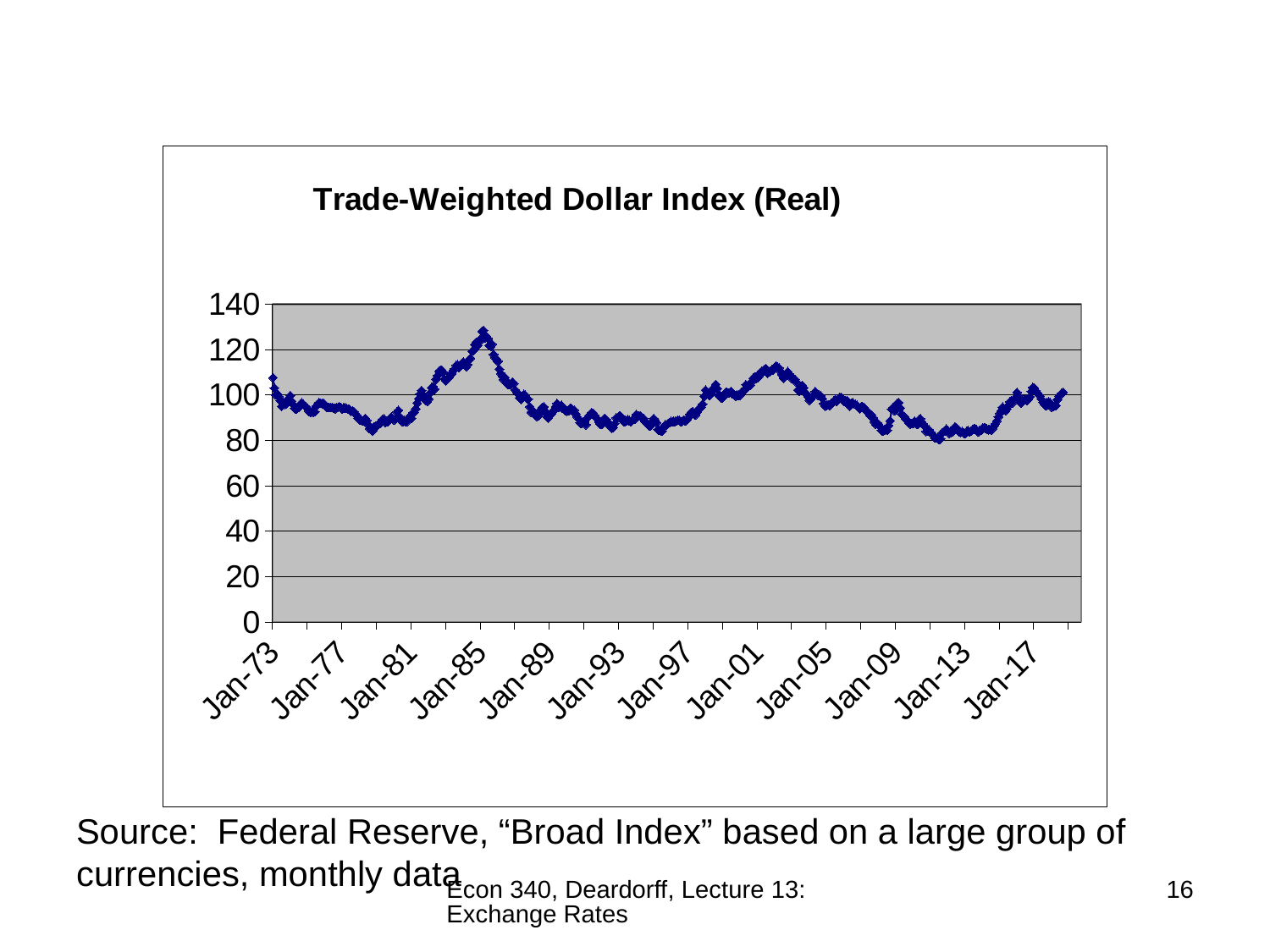
What kind of chart is shown on the slide? line chart Is the value of the index around Jan-13 greater or less than 100? less Is the value of the index around Jan-81 greater or less than 100? less What is the title of the chart? Trade-Weighted Dollar Index (Real) Is the value of the index at Jan-73 greater or less than 100? greater Does the index rise or fall between Jan-81 and Jan-85? rise Which is larger, the index value around Jan-01 or around Jan-09? Jan-01 What is the highest value shown on the vertical axis of the chart? 140 How many date labels are shown along the x axis of the chart? 12 Near which labeled date does the index reach its highest point? Jan-85